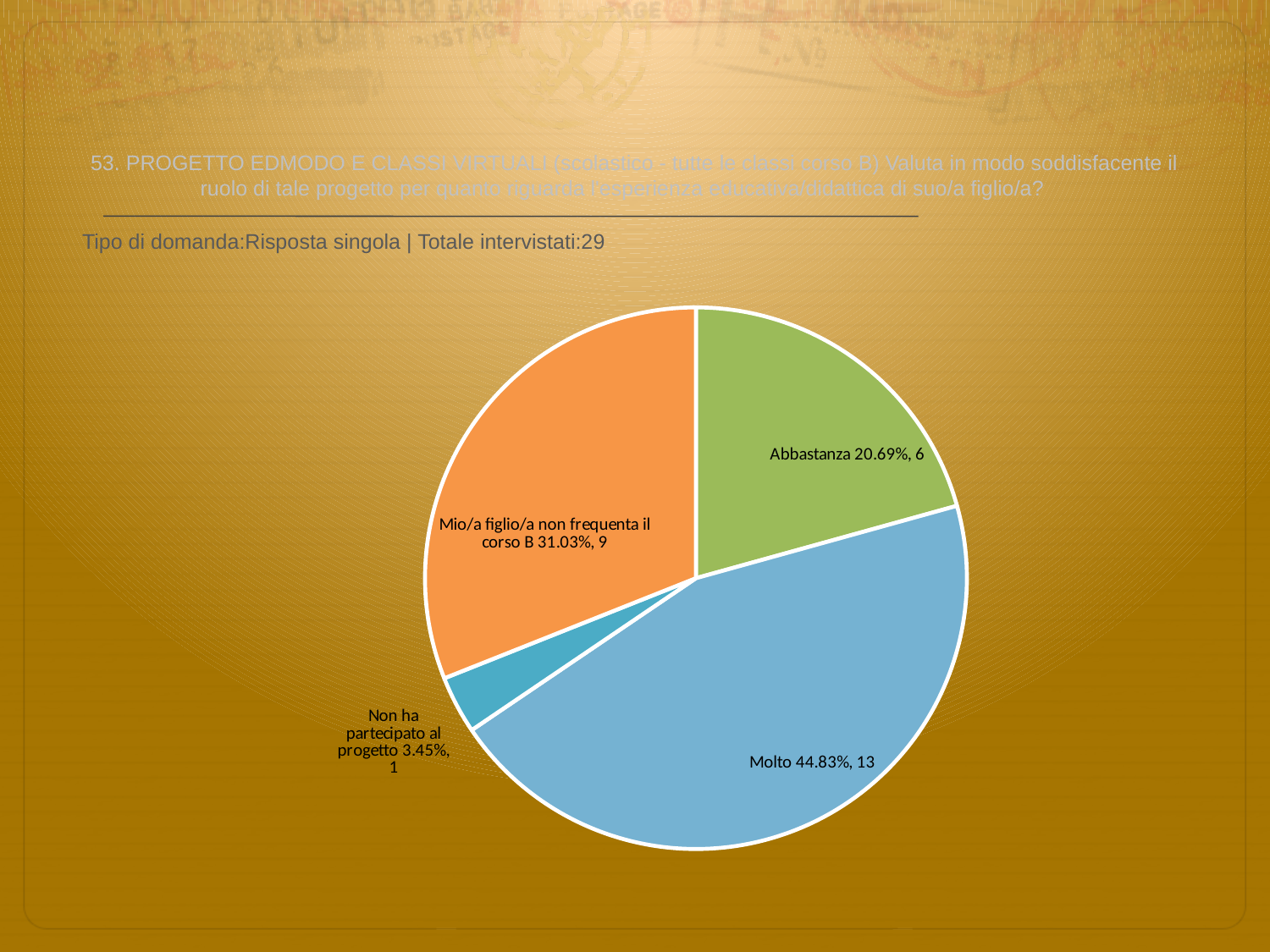
How many respondents answered 'Non ha partecipato al progetto'? 1 Which has more respondents, 'Mio/a figlio/a non frequenta il corso B' or 'Abbastanza'? Mio/a figlio/a non frequenta il corso B Which category has the largest slice? Molto What kind of chart is shown on the slide? pie chart What colour is the 'Molto' slice? blue What percentage share does the 'Molto' slice have? 44.83% What percentage share does the 'Mio/a figlio/a non frequenta il corso B' slice have? 31.03% How many respondents answered 'Abbastanza'? 6 How many slices does the pie chart have? 4 What is the total number of respondents shown on the slide? 29 What is the difference in respondent count between 'Molto' and 'Abbastanza'? 7 Which category has the smallest slice? Non ha partecipato al progetto